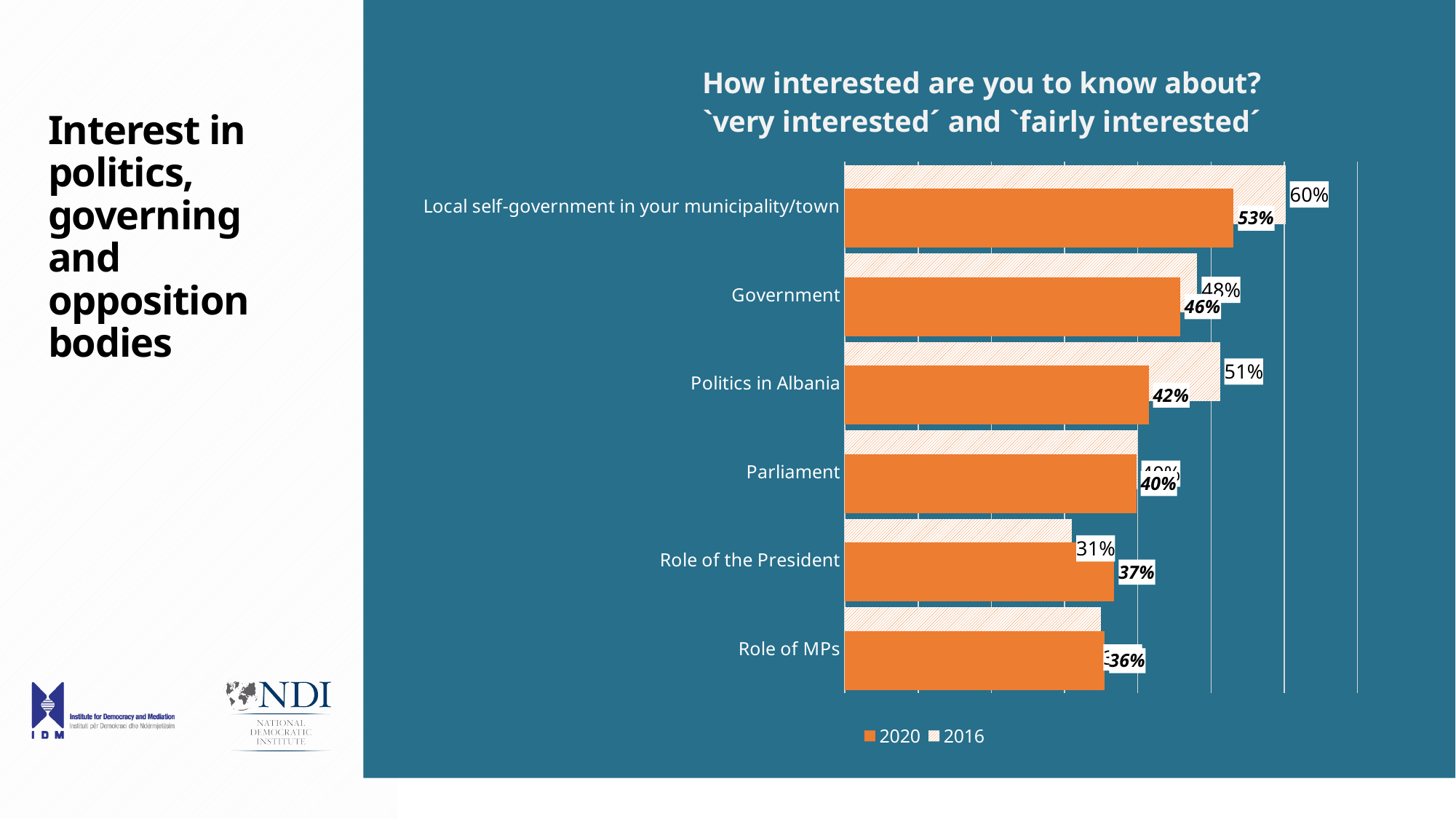
How many series does the legend list? 2 What is the 2020 value for Local self-government in your municipality/town? 53% What is the difference between the 2016 and 2020 values for Local self-government in your municipality/town? 7% What is the 2016 value for Local self-government in your municipality/town? 60% For Politics in Albania, which year has the larger value, 2016 or 2020? 2016 What is the 2020 value for Government? 46% What is the 2016 value for Politics in Albania? 51% Which category has the highest 2020 value? Local self-government in your municipality/town What is the 2016 value for Role of the President? 31% What is the 2020 value for Role of the President? 37% What is the 2020 value for Politics in Albania? 42% How many categories are shown on the chart? 6